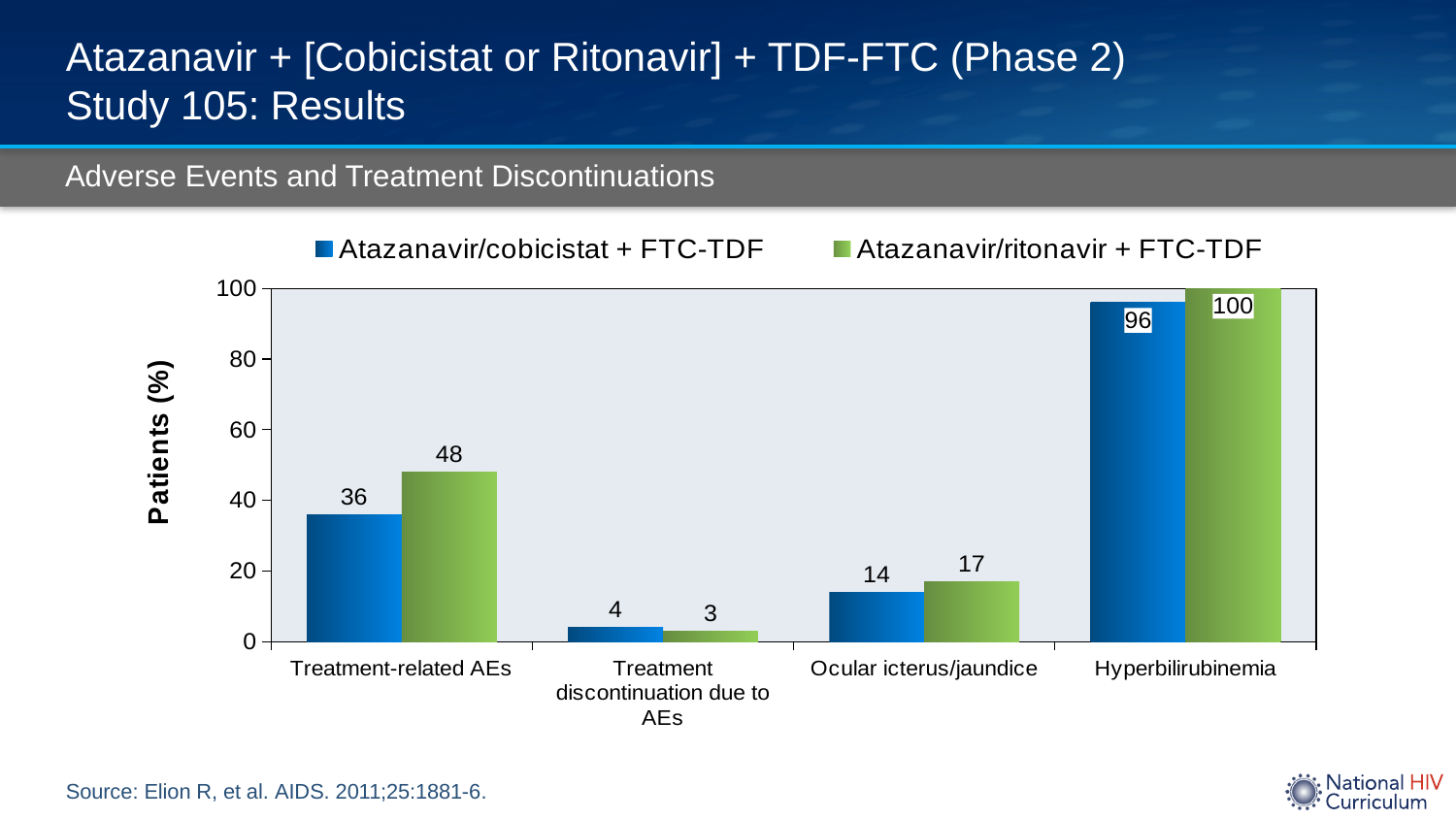
What is the difference between the two series in the Treatment-related AEs category? 12 What is the label of the y axis? Patients (%) What kind of chart is shown on the slide? Bar chart Which category has the highest value for Atazanavir/cobicistat + FTC-TDF? Hyperbilirubinemia What is the value for Atazanavir/cobicistat + FTC-TDF in the Treatment-related AEs category? 36 Which category has the lowest value for Atazanavir/ritonavir + FTC-TDF? Treatment discontinuation due to AEs In the Treatment discontinuation due to AEs category, which series has the larger value? Atazanavir/cobicistat + FTC-TDF How many categories are shown on the x axis? 4 Is the value for Atazanavir/cobicistat + FTC-TDF in the Hyperbilirubinemia category greater or less than 80? greater What is the value for Atazanavir/ritonavir + FTC-TDF in the Ocular icterus/jaundice category? 17 How many series does the legend list? 2 What is the value for Atazanavir/ritonavir + FTC-TDF in the Hyperbilirubinemia category? 100